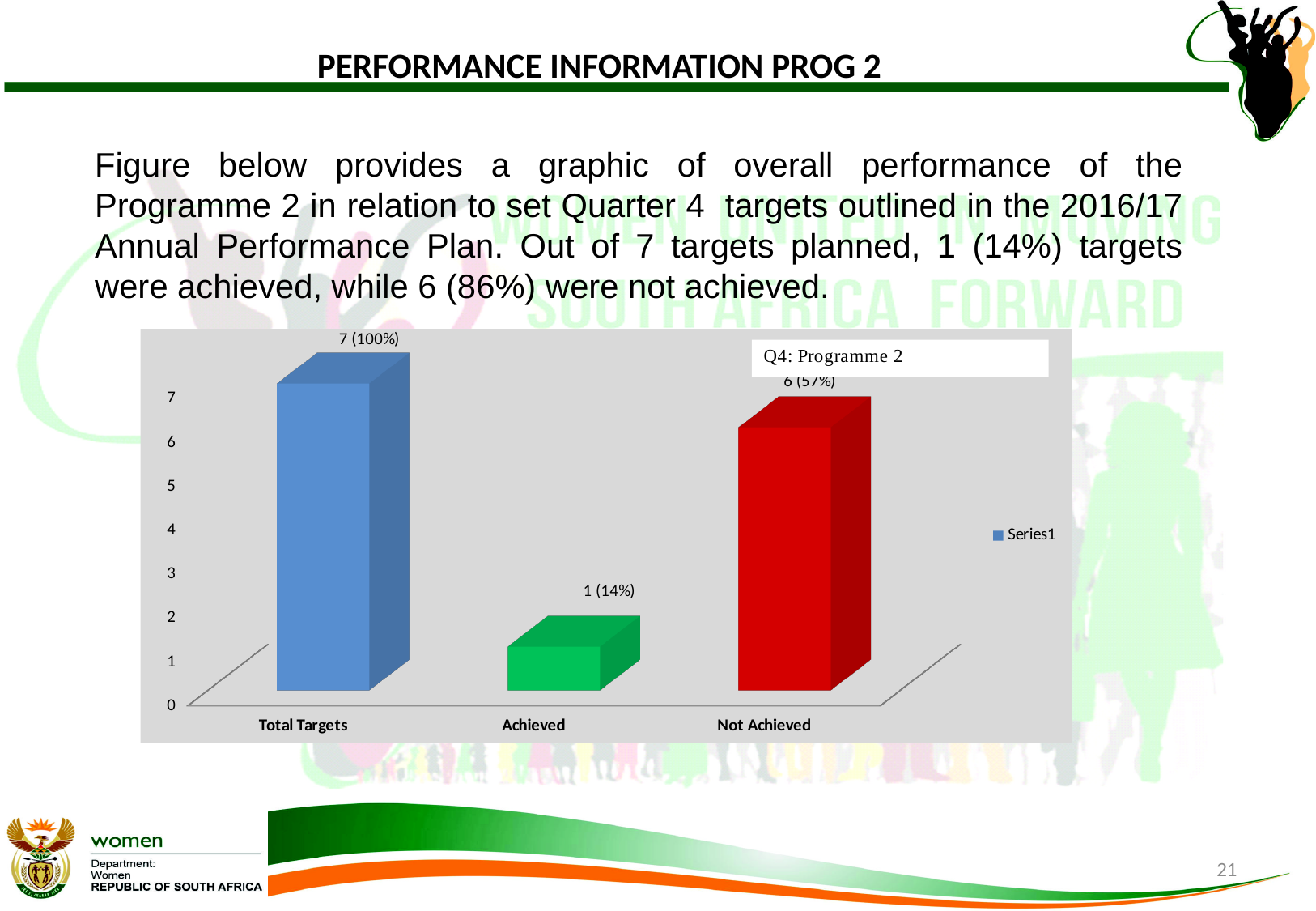
How many series does the chart legend list? 1 Is the value for Achieved greater or less than 3? less Which is larger, the bar for Not Achieved or the bar for Achieved? Not Achieved What is the data label on the Total Targets bar? 7 (100%) What is the title of the chart? Q4: Programme 2 Which category has the lowest bar? Achieved What kind of chart is shown on the slide? Bar chart Is the value for Not Achieved greater or less than 4? greater How many categories are shown on the x axis of the chart? 3 What colour is the Not Achieved bar? Red Which category has the highest bar? Total Targets What is the data label on the Achieved bar? 1 (14%)